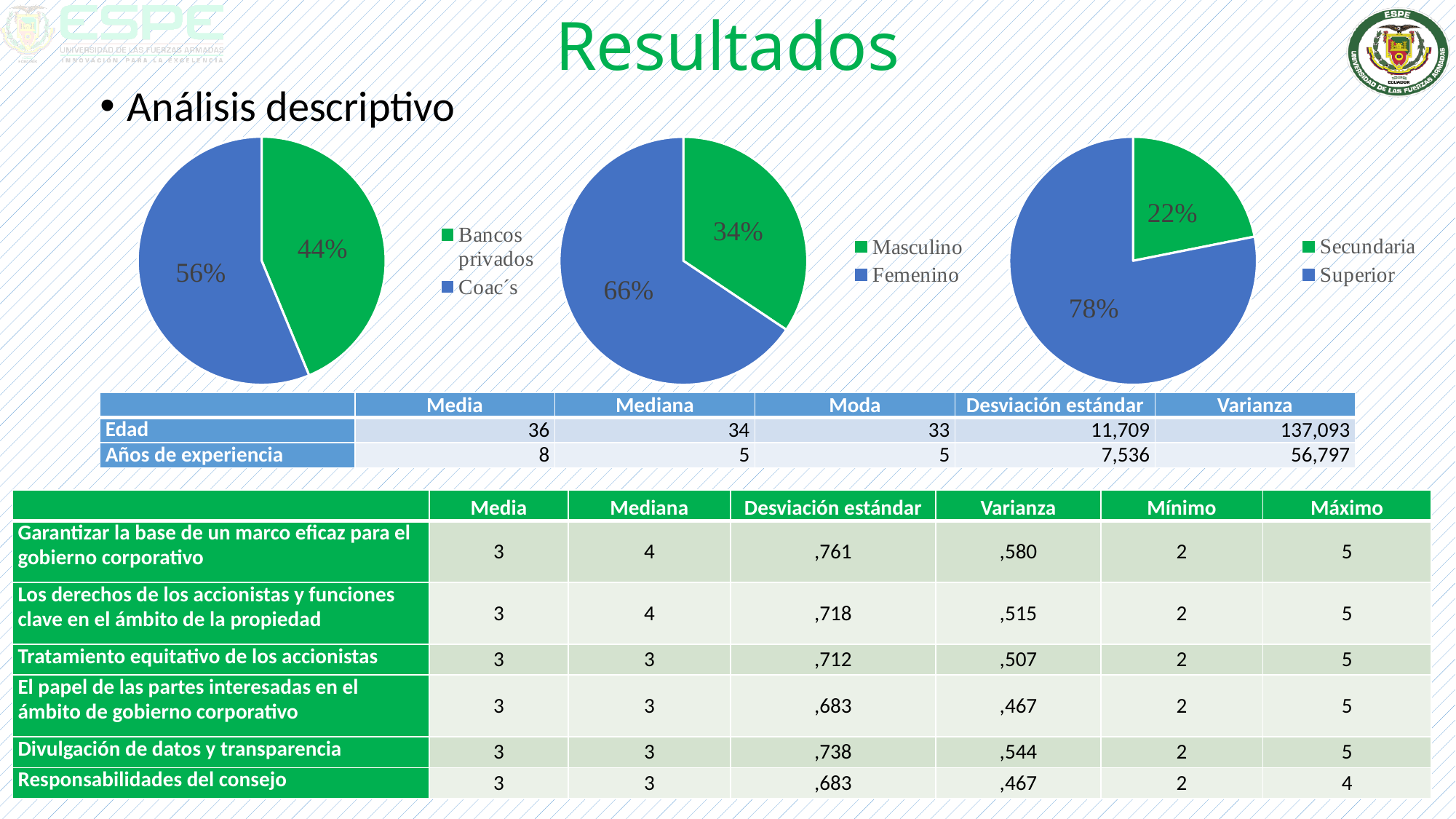
In the left pie chart, what share is labelled for Bancos privados? 44% What type of chart is the left chart on the slide? Pie chart In the right pie chart, what share is labelled for Secundaria? 22% In the middle pie chart, what share is labelled for Femenino? 66% In the left pie chart, what share is labelled for Coac´s? 56% In the middle pie chart, which is larger, Masculino or Femenino? Femenino In the right pie chart, what share is labelled for Superior? 78% In the middle pie chart, what share is labelled for Masculino? 34% In the left pie chart, what is the difference in percentage points between Coac´s and Bancos privados? 12 In the right pie chart, which category has the largest slice? Superior How many categories does the legend of the right pie chart list? 2 In the middle pie chart, which category has the smallest slice? Masculino